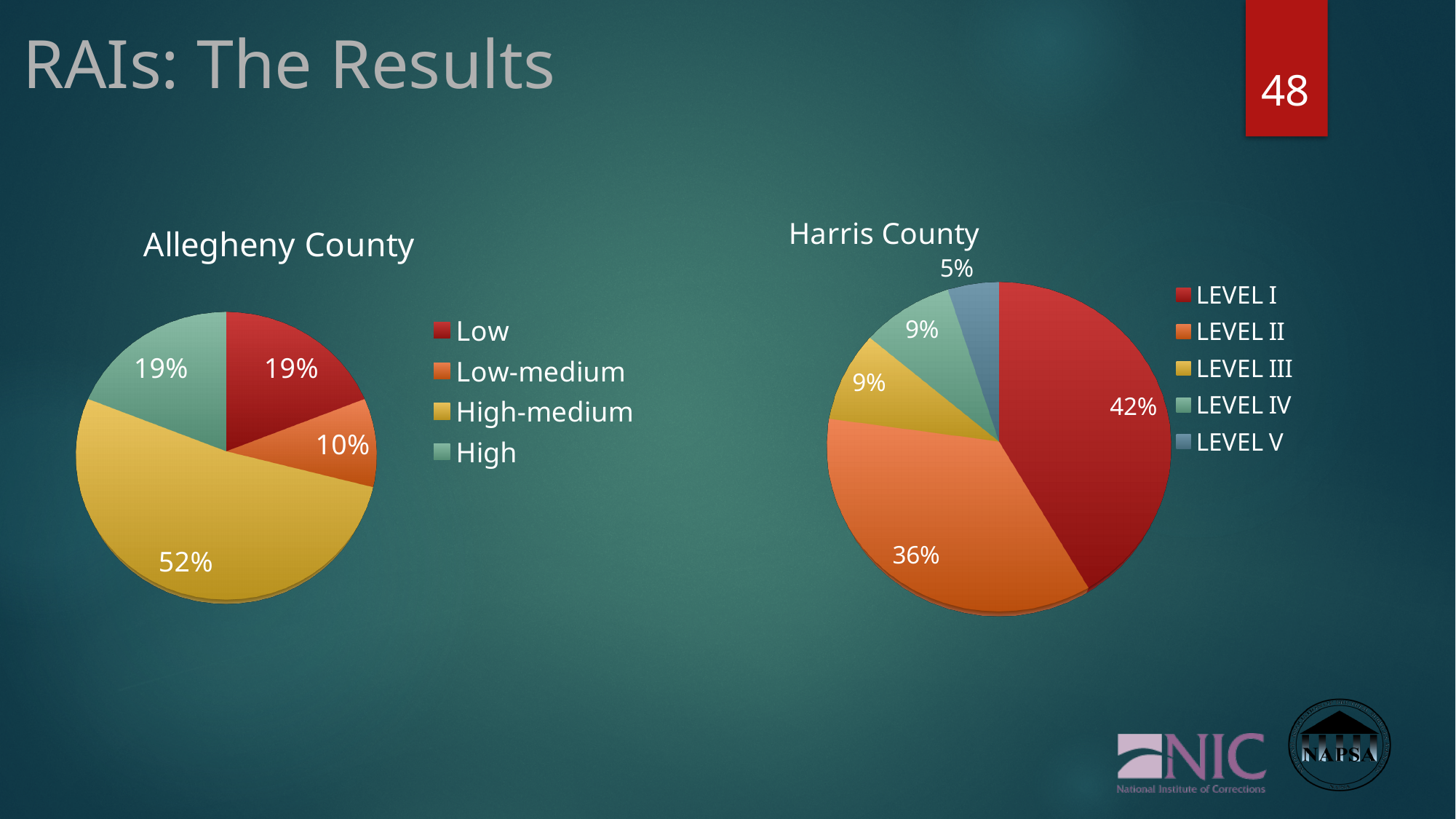
In the Harris County chart, how many categories does the legend list? 5 In the Harris County chart, what share of the pie is LEVEL II? 36% In the Allegheny County chart, what share of the pie is High-medium? 52% In the Allegheny County chart, what share of the pie is Low-medium? 10% In the Harris County chart, what share of the pie is LEVEL V? 5% In the Allegheny County chart, which category has the largest share? High-medium What kind of chart is the Allegheny County chart? Pie chart In the Harris County chart, what is the difference between the LEVEL I and LEVEL II shares? 6% In the Harris County chart, which level has the largest share? LEVEL I In the Harris County chart, which level has the smallest share? LEVEL V In the Allegheny County chart, which category has the smallest share? Low-medium In the Allegheny County chart, how many categories does the legend list? 4